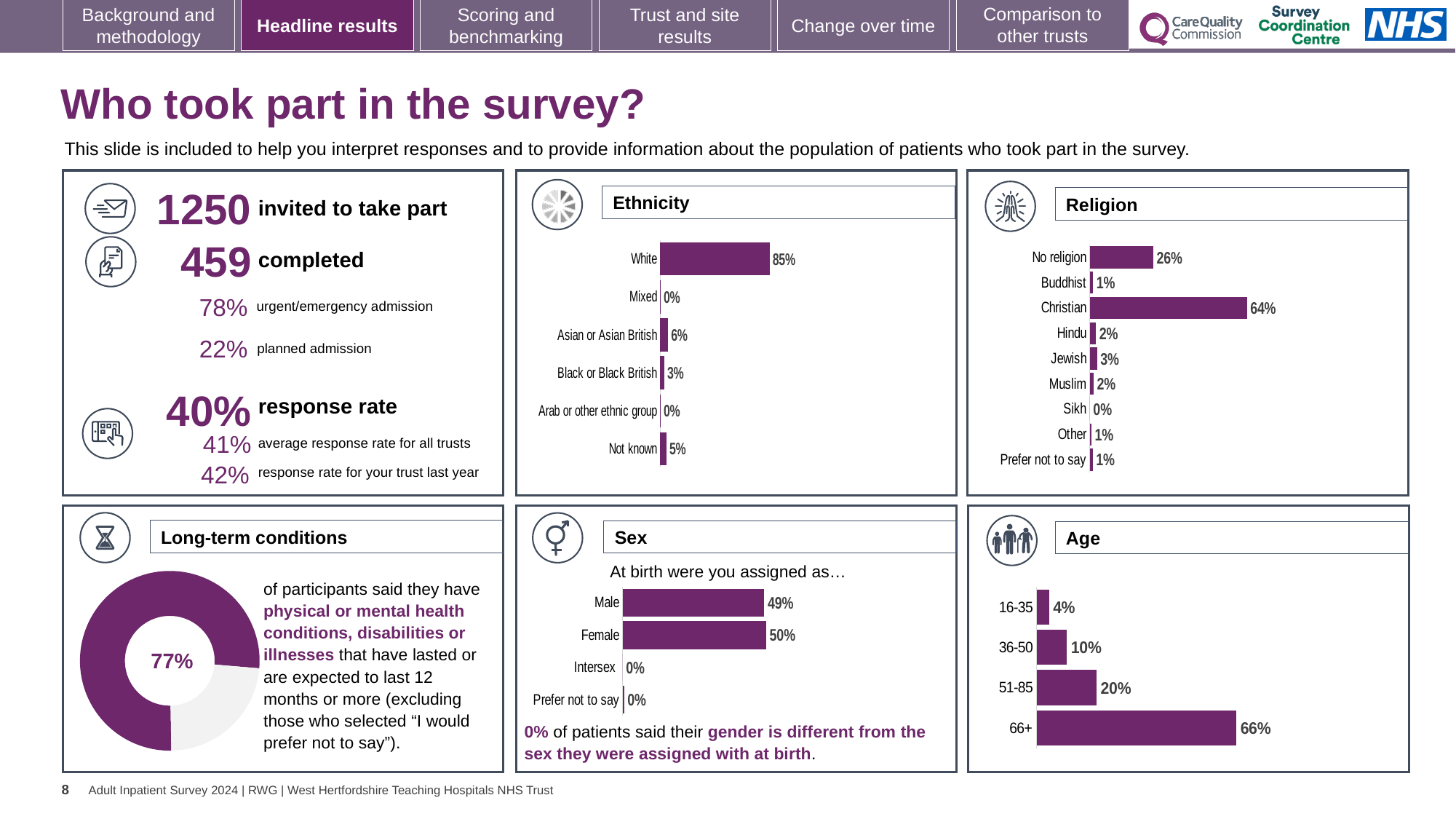
How many categories does the Religion chart show? 9 In the Religion chart, which category has the highest value? Christian How many categories does the Age chart show? 4 In the Ethnicity chart, what percentage of respondents were White? 85% In the Religion chart, what is the value for No religion? 26% In the Age chart, what is the difference between the 66+ and 51-85 values? 46% In the Age chart, do the values rise or fall from 16-35 to 66+? Rise What kind of chart is the Long-term conditions chart? Doughnut chart In the Long-term conditions chart, what share of participants said they have physical or mental health conditions, disabilities or illnesses? 77% What kind of chart is the Ethnicity chart? Bar chart In the Ethnicity chart, what is the value for Asian or Asian British? 6% In the Sex chart, which is larger, Male or Female? Female